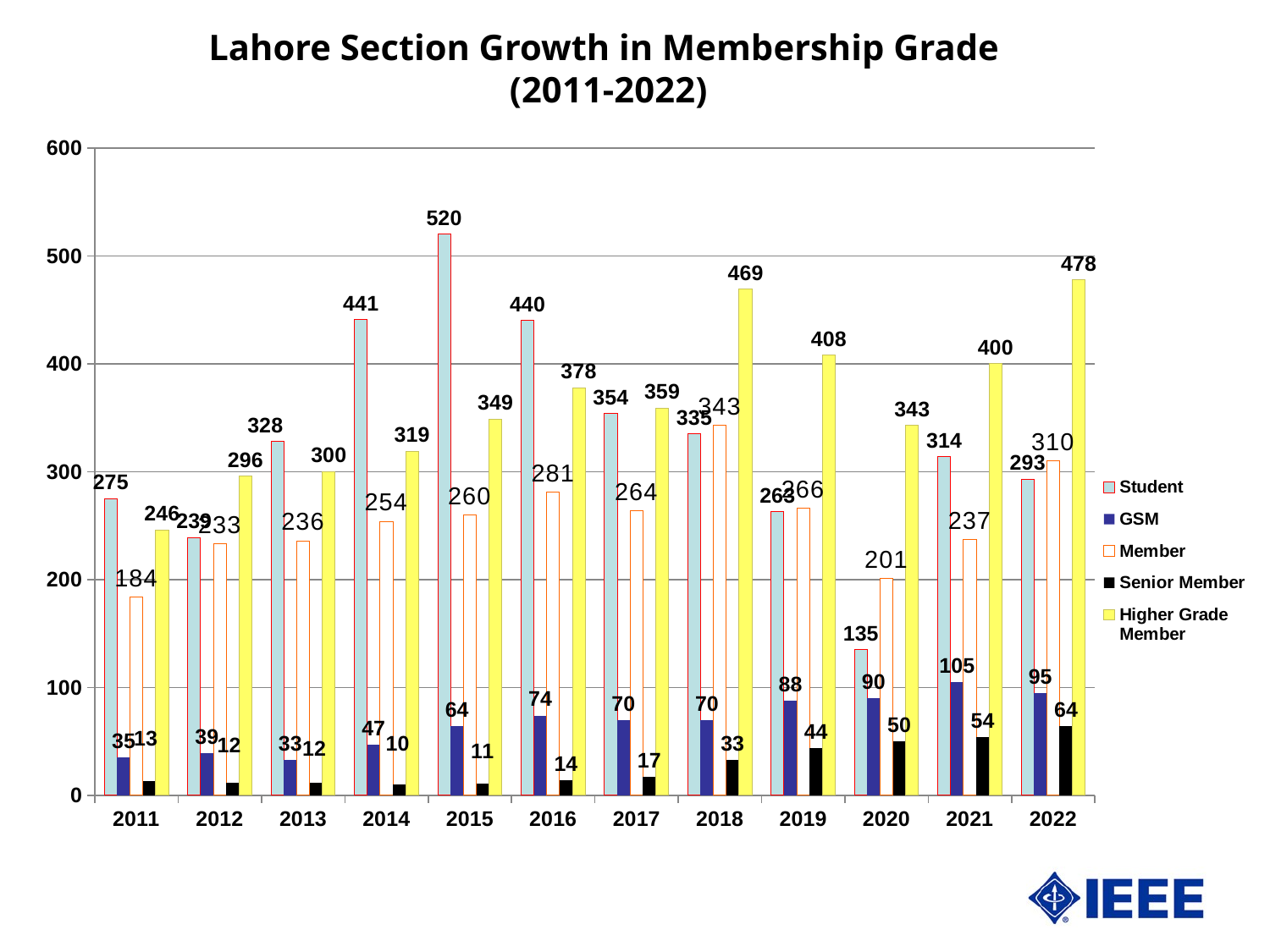
How many years are shown on the x axis? 12 Do the Senior Member values rise or fall from 2017 to 2022? rise In which year is the Student value lowest? 2020 What is the GSM value for 2021? 105 What type of chart is shown on the slide? bar chart What is the title of the chart? Lahore Section Growth in Membership Grade (2011-2022) How many series does the legend list? 5 What is the Student value for 2015? 520 What is the difference between the Higher Grade Member values for 2018 and 2017? 110 What is the Higher Grade Member value for 2022? 478 Which is larger in 2020, the Member value or the Student value? Member In which year is the Student value highest? 2015